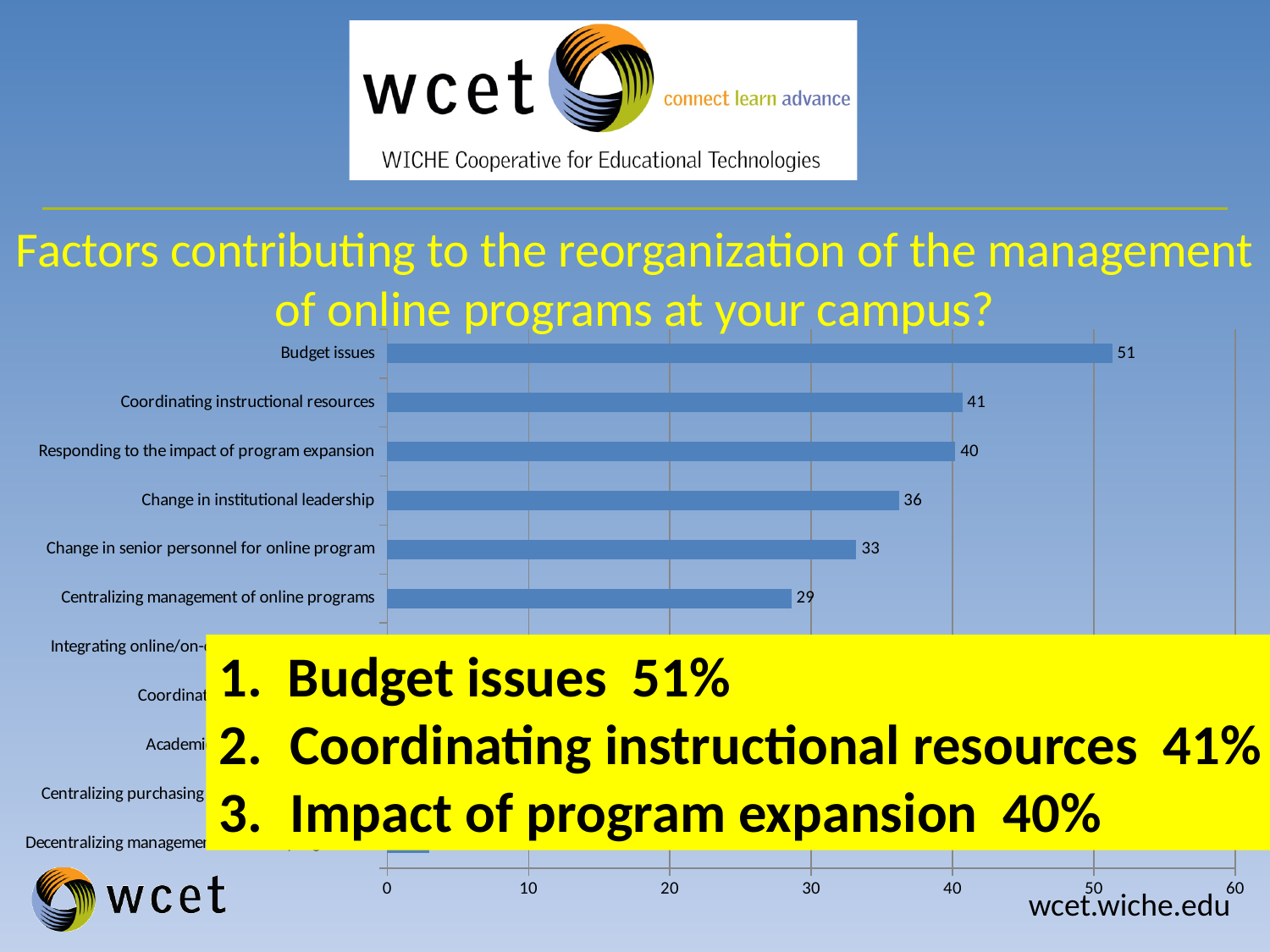
Which category has the highest value? Budget issues What is the value for Centralizing management of online programs? 29 What is the value for Change in senior personnel for online program? 33 What is the value for Coordinating instructional resources? 41 What is the value for Budget issues? 51 What is the value for Change in institutional leadership? 36 Is the value for Budget issues greater or less than 50? greater What is the difference between the values for Change in institutional leadership and Centralizing management of online programs? 7 What kind of chart is shown on the slide? Bar chart What is the difference between the values for Budget issues and Coordinating instructional resources? 10 What is the value for Responding to the impact of program expansion? 40 Which is larger, the value for Change in senior personnel for online program or the value for Centralizing management of online programs? Change in senior personnel for online program